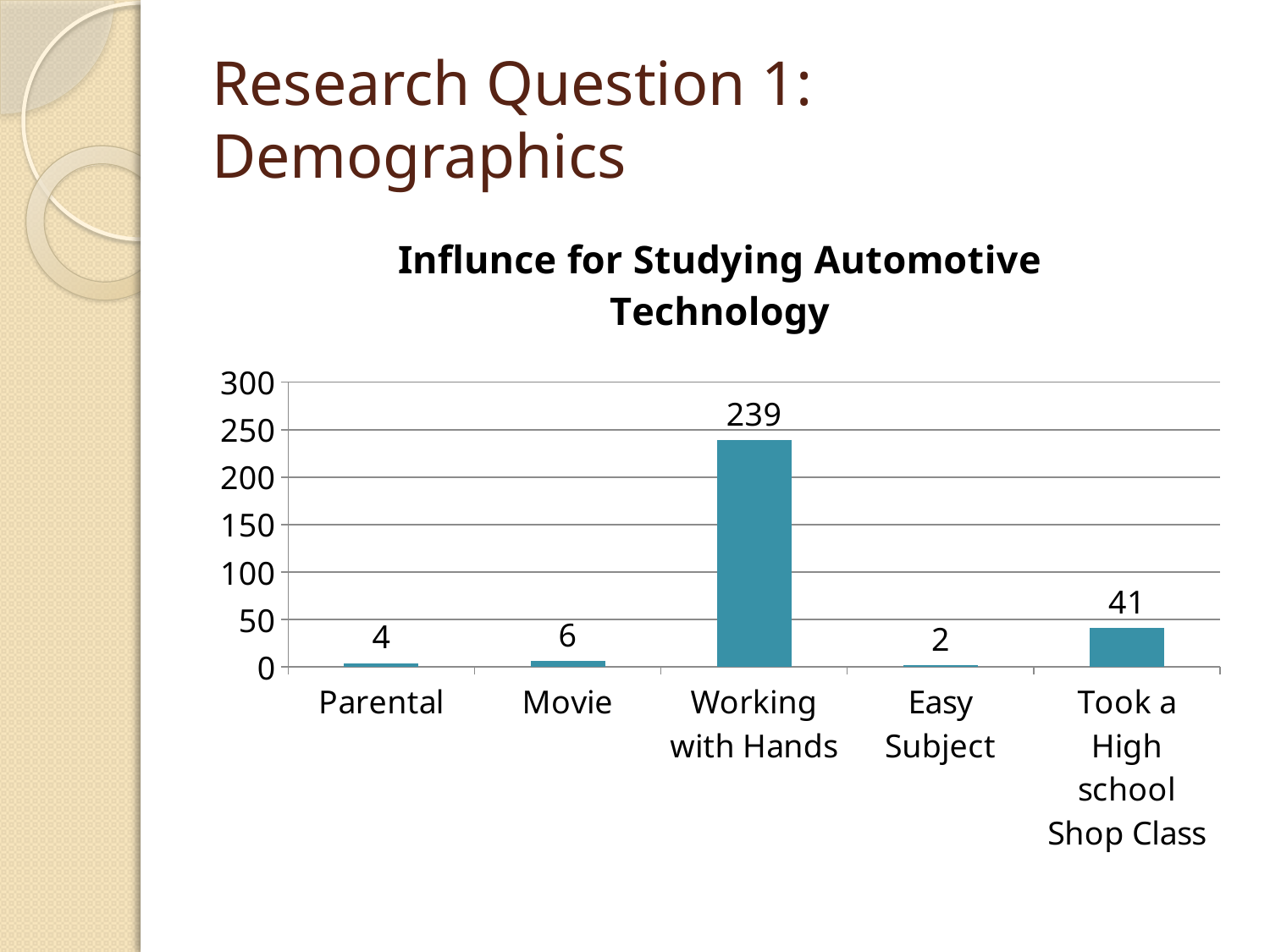
Is the value for Working with Hands greater or less than 200? greater What is the value for Movie? 6 What is the title of the chart? Influnce for Studying Automotive Technology Which is larger, the value for Movie or the value for Parental? Movie What is the value for Parental? 4 How many categories are shown on the x axis? 5 What is the value for Working with Hands? 239 Which category has the lowest value? Easy Subject What is the value for Took a High school Shop Class? 41 Which category has the highest value? Working with Hands What is the difference between the values for Working with Hands and Took a High school Shop Class? 198 What kind of chart is shown on the slide? Bar chart